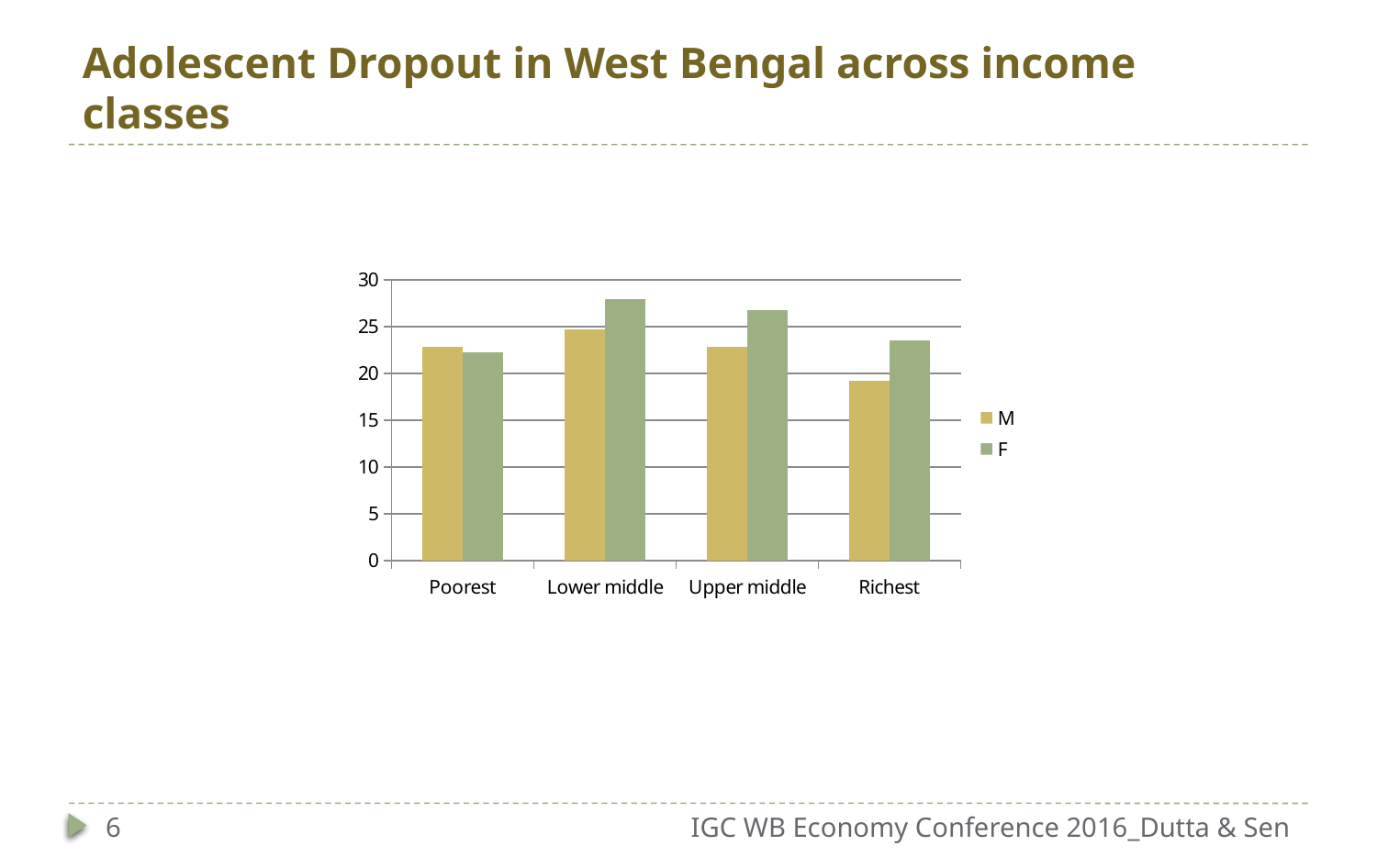
Which income class has the highest value for the M series? Lower middle How many income categories are shown on the x axis? 4 Which income class has the highest value for the F series? Lower middle Is the value for M in the Richest class greater or less than 20? less What kind of chart is shown on the slide? bar chart Which income class has the lowest value for the M series? Richest Is the value for F in the Lower middle class greater or less than 25? greater What are the two series names listed in the legend? M and F Is the value for F in the Upper middle class greater or less than 25? greater For the Richest class, which is larger, M or F? F How many series does the legend list? 2 For the Lower middle class, which is larger, M or F? F